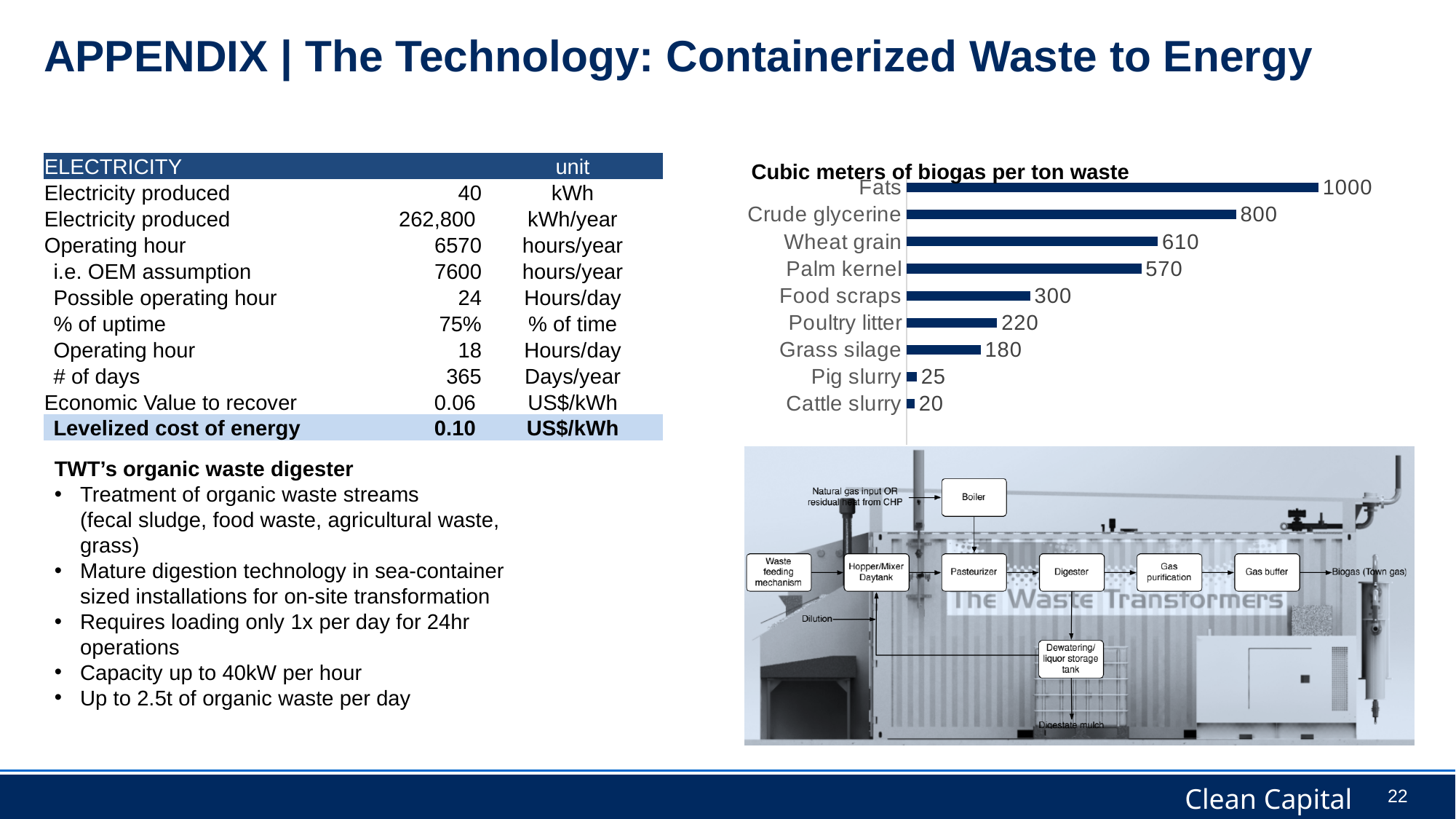
What is the value for Wheat grain in the 'Cubic meters of biogas per ton waste' chart? 610 What is the title of the chart on the slide? Cubic meters of biogas per ton waste What is the value for Fats in the 'Cubic meters of biogas per ton waste' chart? 1000 What kind of chart is the 'Cubic meters of biogas per ton waste' chart? Bar chart What is the difference between Pig slurry and Cattle slurry in the 'Cubic meters of biogas per ton waste' chart? 5 What is the value for Food scraps in the 'Cubic meters of biogas per ton waste' chart? 300 What is the value for Poultry litter in the 'Cubic meters of biogas per ton waste' chart? 220 How many categories are shown in the 'Cubic meters of biogas per ton waste' chart? 9 What is the difference between Crude glycerine and Wheat grain in the 'Cubic meters of biogas per ton waste' chart? 190 Which category has the highest value in the 'Cubic meters of biogas per ton waste' chart? Fats Which is larger in the 'Cubic meters of biogas per ton waste' chart, Palm kernel or Grass silage? Palm kernel Which category has the lowest value in the 'Cubic meters of biogas per ton waste' chart? Cattle slurry